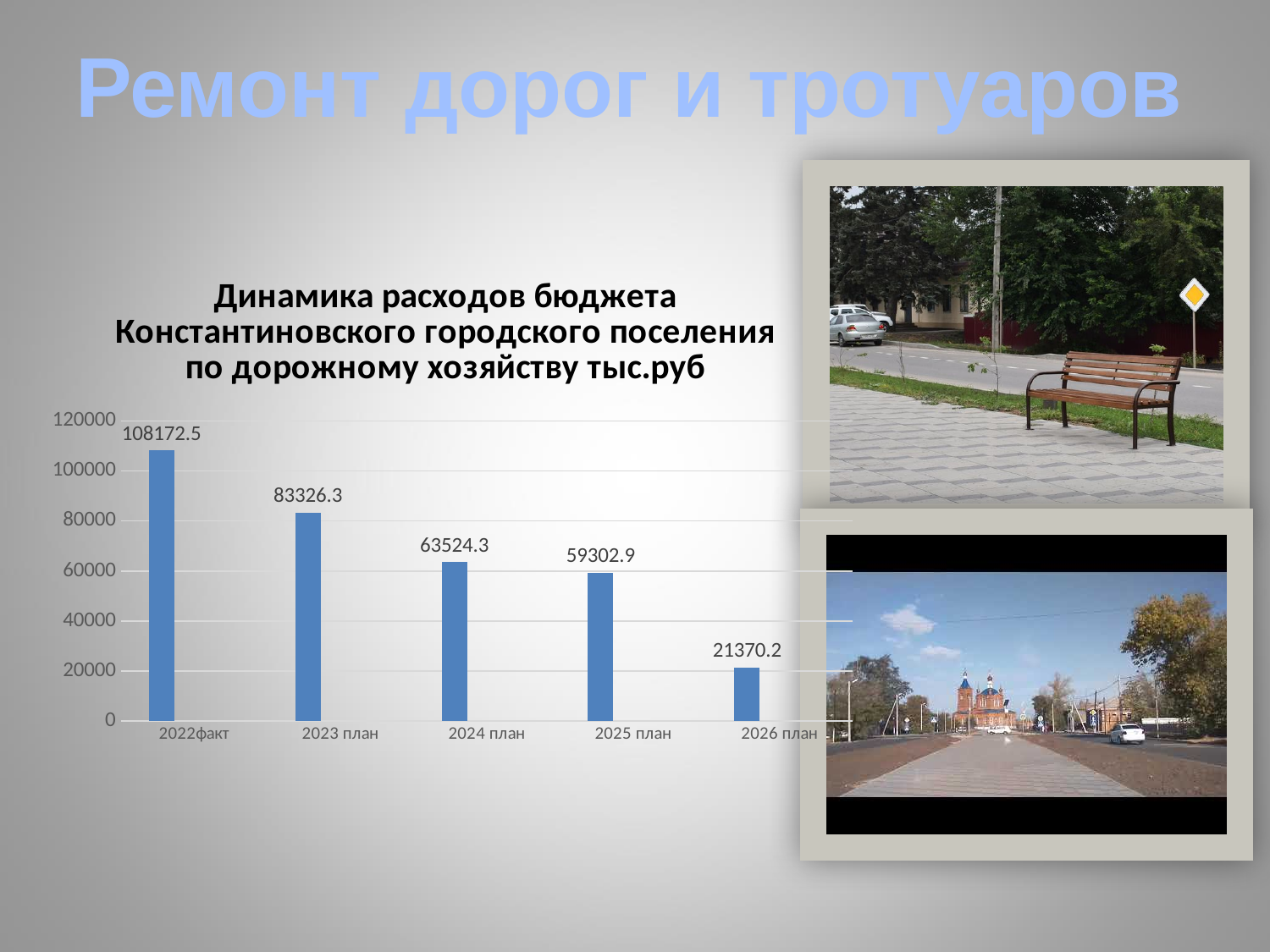
What is the value for 2022факт? 108172.5 Which is larger, the value for 2023 план or the value for 2024 план? 2023 план Which category has the highest value? 2022факт What is the difference between the values for 2025 план and 2026 план? 37932.7 How many categories are shown on the x axis? 5 Is the value for 2025 план greater or less than 60000? less Which category has the lowest value? 2026 план What is the difference between the values for 2022факт and 2023 план? 24846.2 What is the value for 2024 план? 63524.3 Do the values rise or fall from 2022факт to 2026 план? fall What is the value for 2026 план? 21370.2 What kind of chart is shown on the slide? bar chart